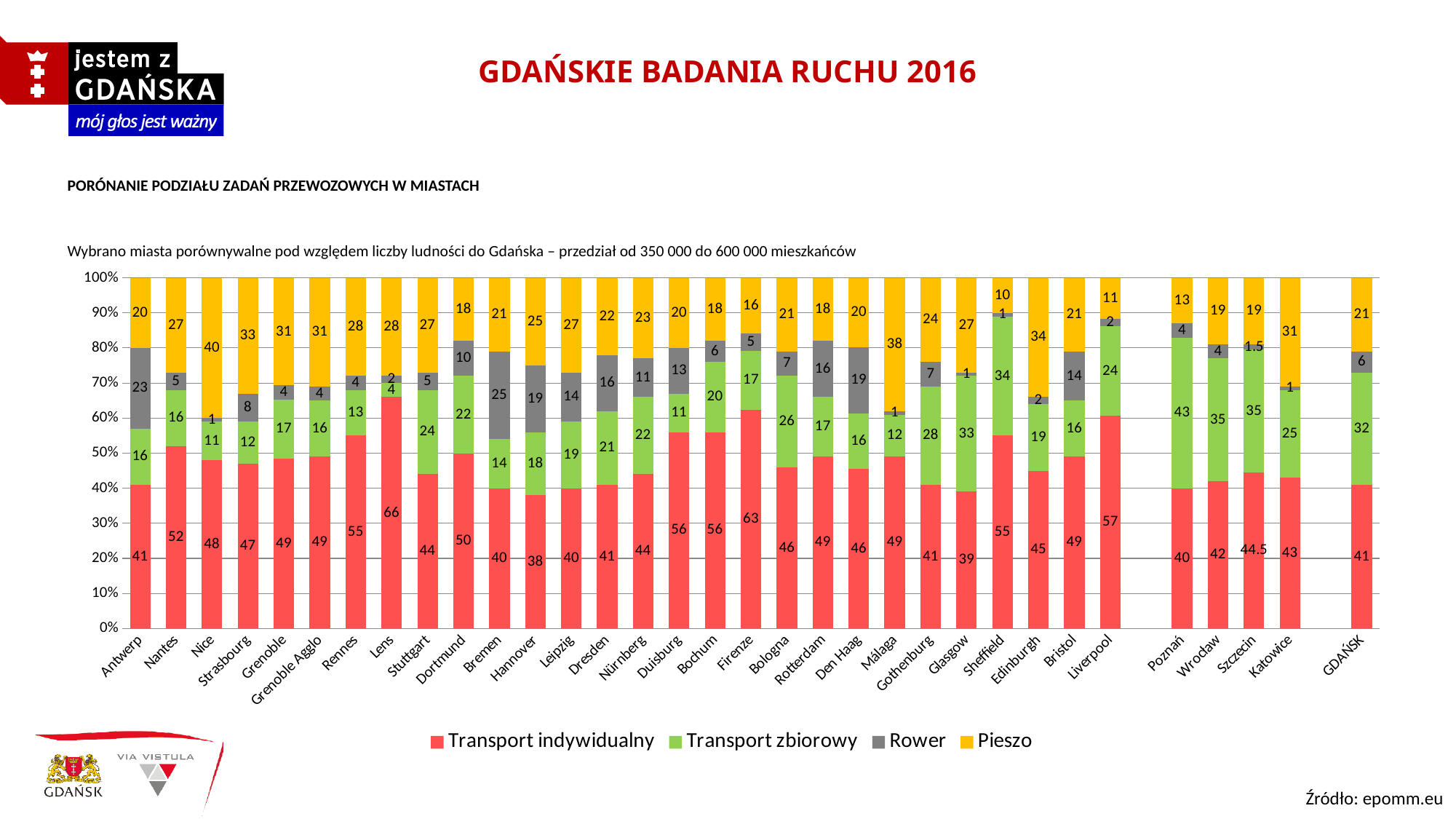
What is the Rower value for Antwerp? 23 Which city has the highest Transport indywidualny value? Lens How many series does the legend list? 4 What is the Pieszo value for Nice? 40 Which colour represents Pieszo in the legend? Yellow Which has the larger Transport zbiorowy value, Poznań or GDAŃSK? Poznań What is the difference between the Pieszo value for Nice and the Pieszo value for Sheffield? 30 How many cities are shown on the x axis? 33 What kind of chart is shown on the slide? Stacked bar chart Which city has the highest Transport zbiorowy value? Poznań What is the Transport indywidualny value for GDAŃSK? 41 Which city has the lowest Pieszo value? Sheffield